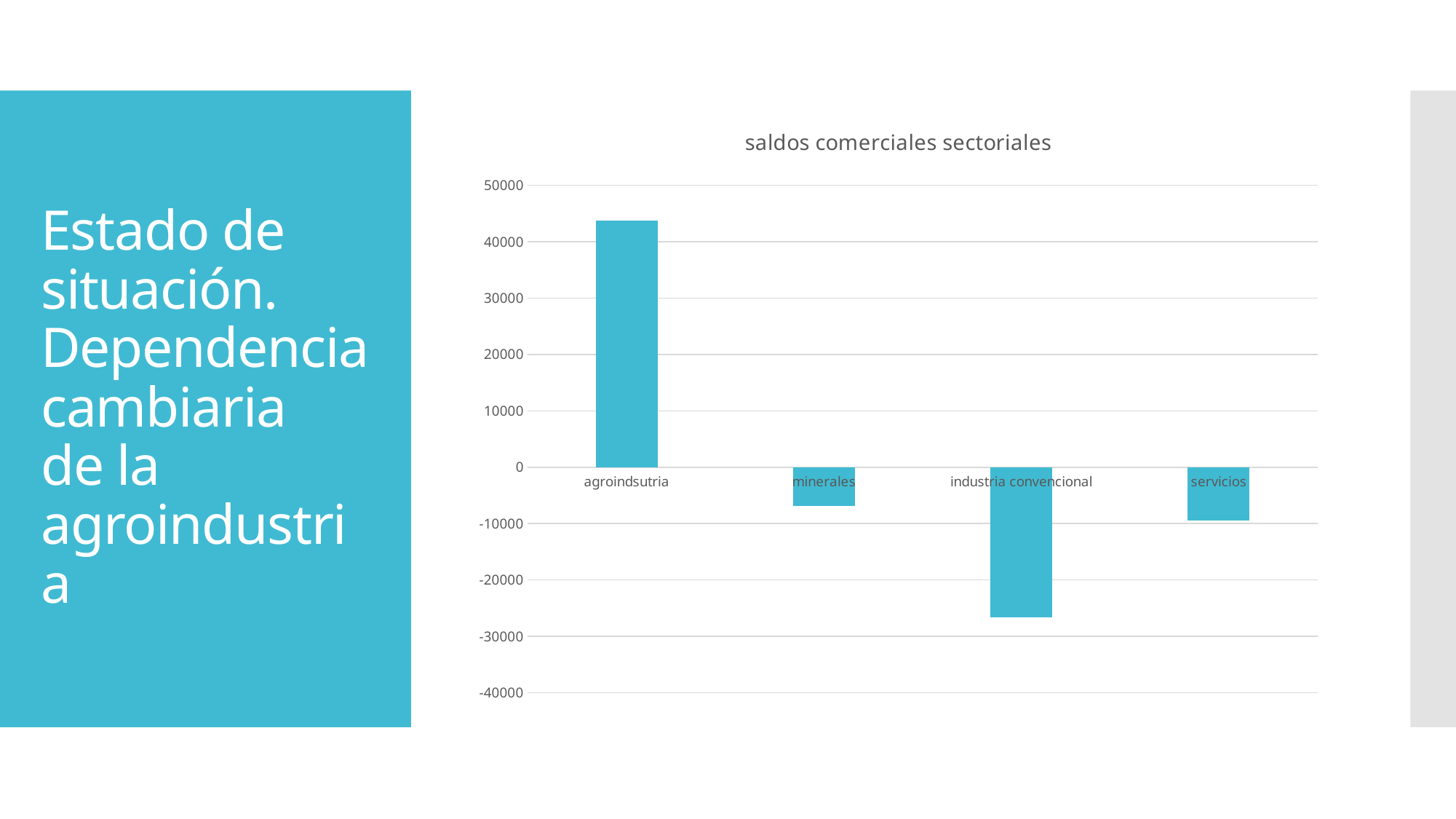
Which is larger, the value for minerales or the value for servicios? minerales What is the title of the chart? saldos comerciales sectoriales Is the value for agroindsutria greater or less than 40000? greater How many categories in the chart have a negative value? 3 Which category has the lowest value in the chart? industria convencional How many categories are shown on the x axis of the chart? 4 Is the value for industria convencional greater or less than -20000? less What kind of chart is shown on the slide? bar chart Which category is the only one with a positive value? agroindsutria Is the value for minerales greater or less than -10000? greater Which category has the highest value in the chart? agroindsutria Which is larger, the value for agroindsutria or the value for industria convencional? agroindsutria